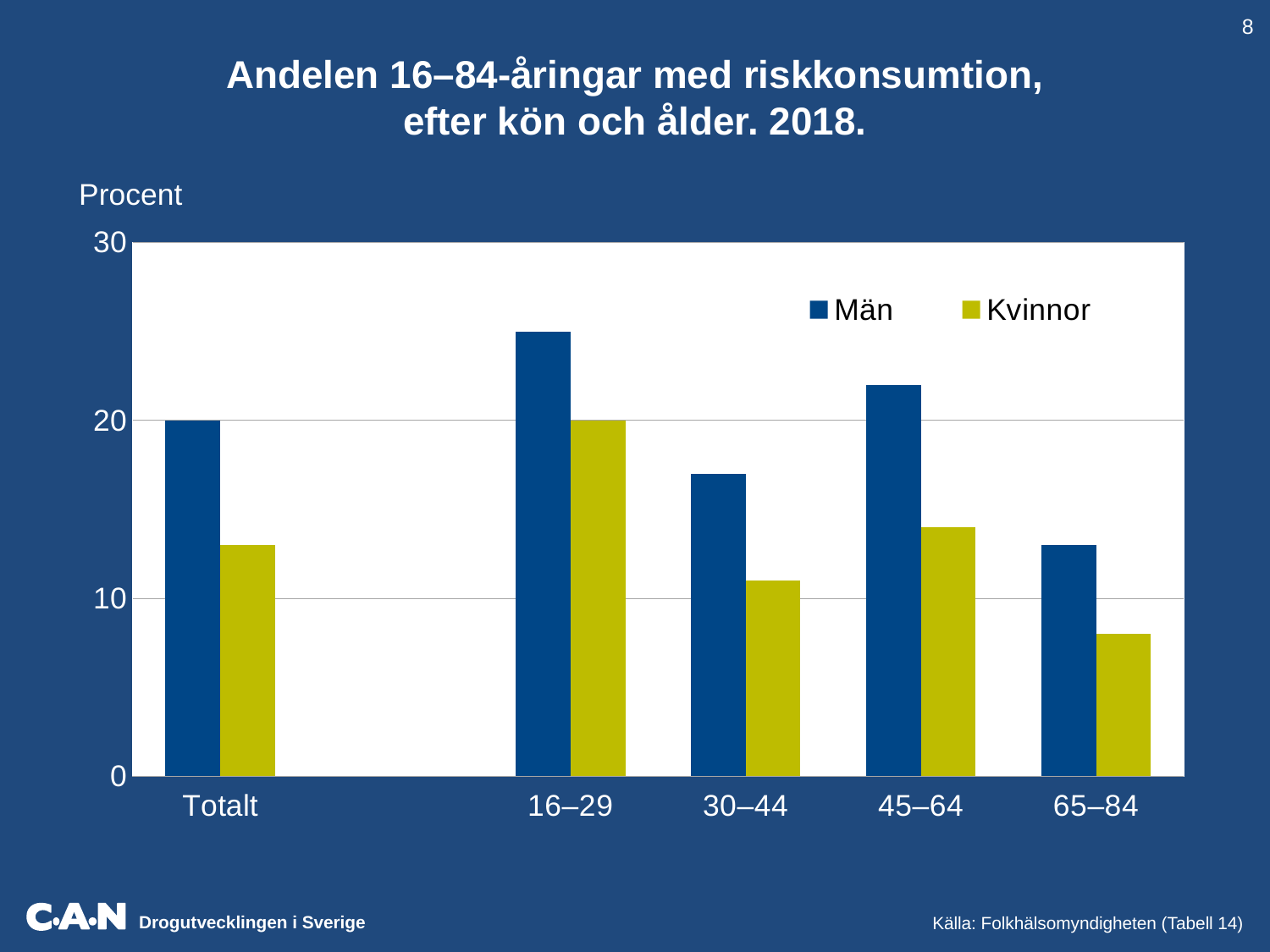
Is the value for Män in the 16–29 category greater or less than 20? greater What is the value for Kvinnor in the 16–29 category? 20 Which is larger in the 30–44 category, Män or Kvinnor? Män What is the label on the y axis? Procent Which age category has the lowest value for Kvinnor? 65–84 Is the value for Kvinnor in the 65–84 category greater or less than 10? less Is the value for Män in the 45–64 category greater or less than 20? greater Which age category has the highest value for Män? 16–29 What is the value for Män in the Totalt category? 20 How many series does the legend list? 2 How many age categories are shown on the x axis? 5 What kind of chart is shown on the slide? bar chart